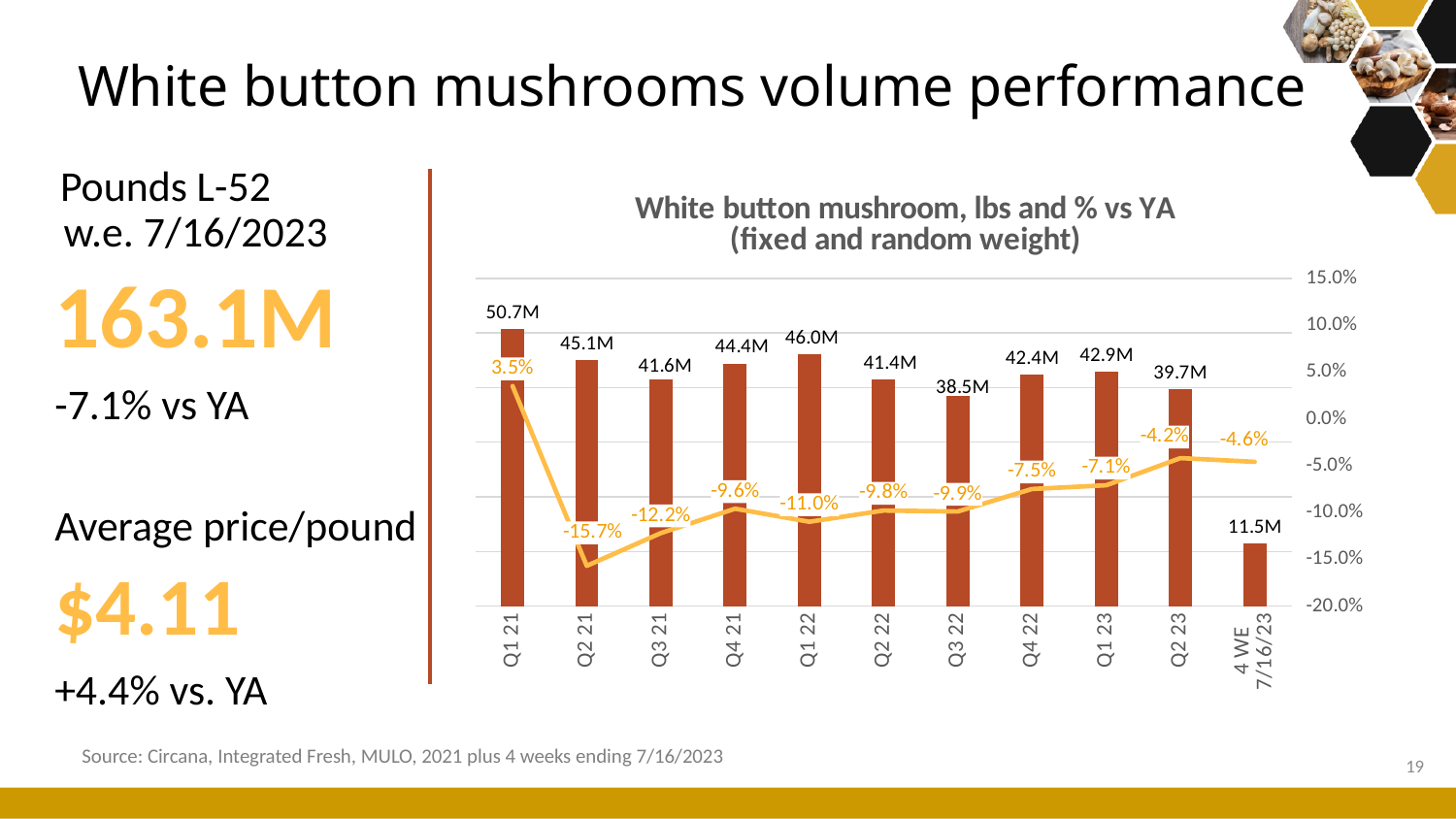
What is the % vs YA value for the 4 WE 7/16/23 period? -4.6% What is the difference in pounds between Q1 22 and Q2 22? 4.6M What is the % vs YA value for Q2 21? -15.7% Which period has the highest volume in pounds? Q1 21 What is the title of the chart? White button mushroom, lbs and % vs YA (fixed and random weight) How many periods are shown on the x axis? 11 What kind of chart is shown on the slide? Bar chart with a line Which has the larger volume in pounds, Q4 22 or Q1 23? Q1 23 Which period has the lowest % vs YA value? Q2 21 What is the volume in pounds for Q3 22? 38.5M What is the volume in pounds for Q1 21? 50.7M Does the % vs YA line generally rise or fall from Q2 21 to Q2 23? Rise